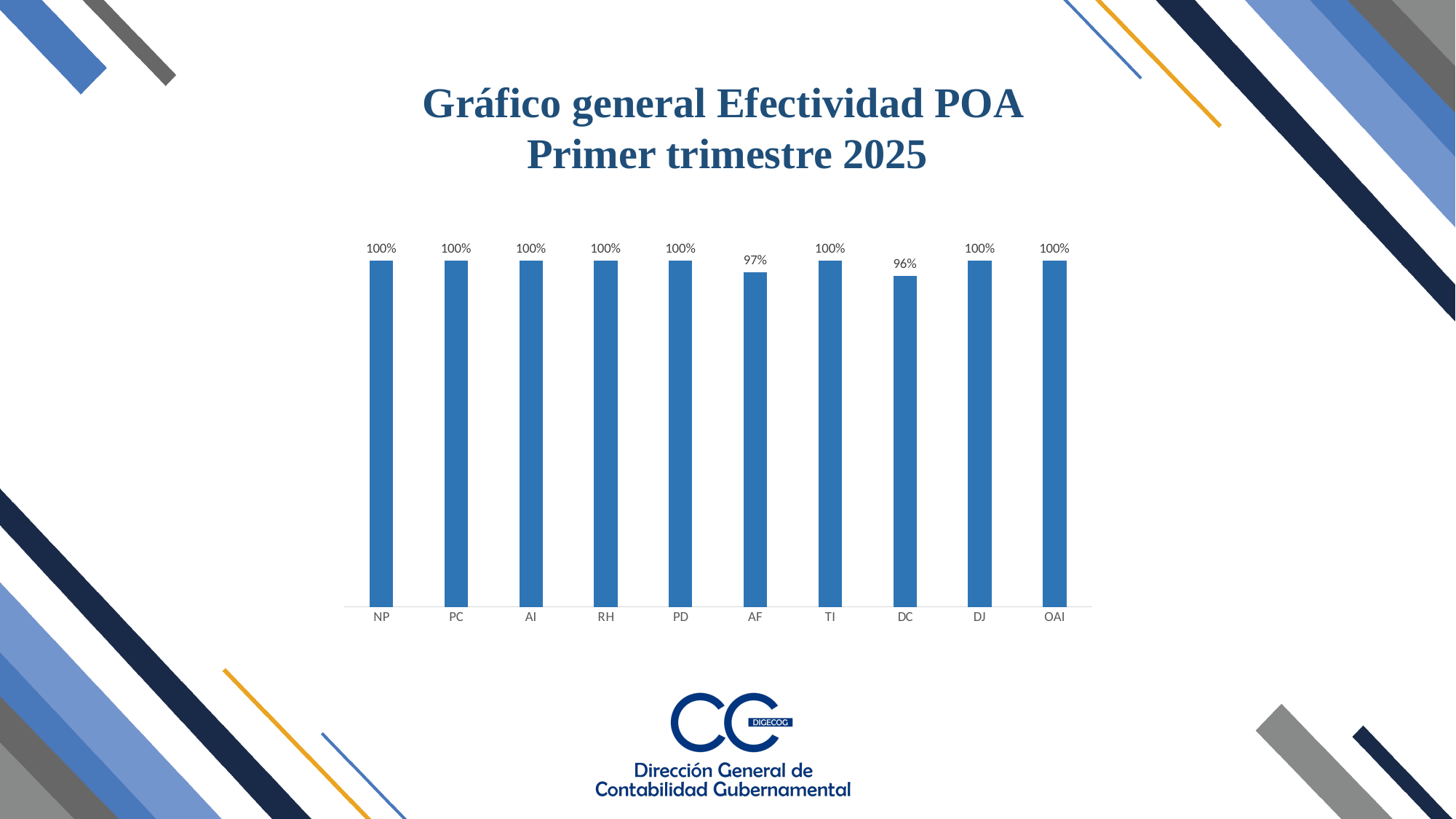
What is the title of the chart on the slide? Gráfico general Efectividad POA Primer trimestre 2025 What is the value for AF? 97% What is the value for DC? 96% Which is larger, the value for AF or the value for DC? AF What is the value for OAI? 100% What is the value for NP? 100% Which is larger, the value for PD or the value for AF? PD What is the difference between the values for TI and DC? 4% What kind of chart is shown on the slide? bar chart How many categories are shown on the x axis? 10 What is the difference between the values for AF and DC? 1% Which category has the lowest value? DC